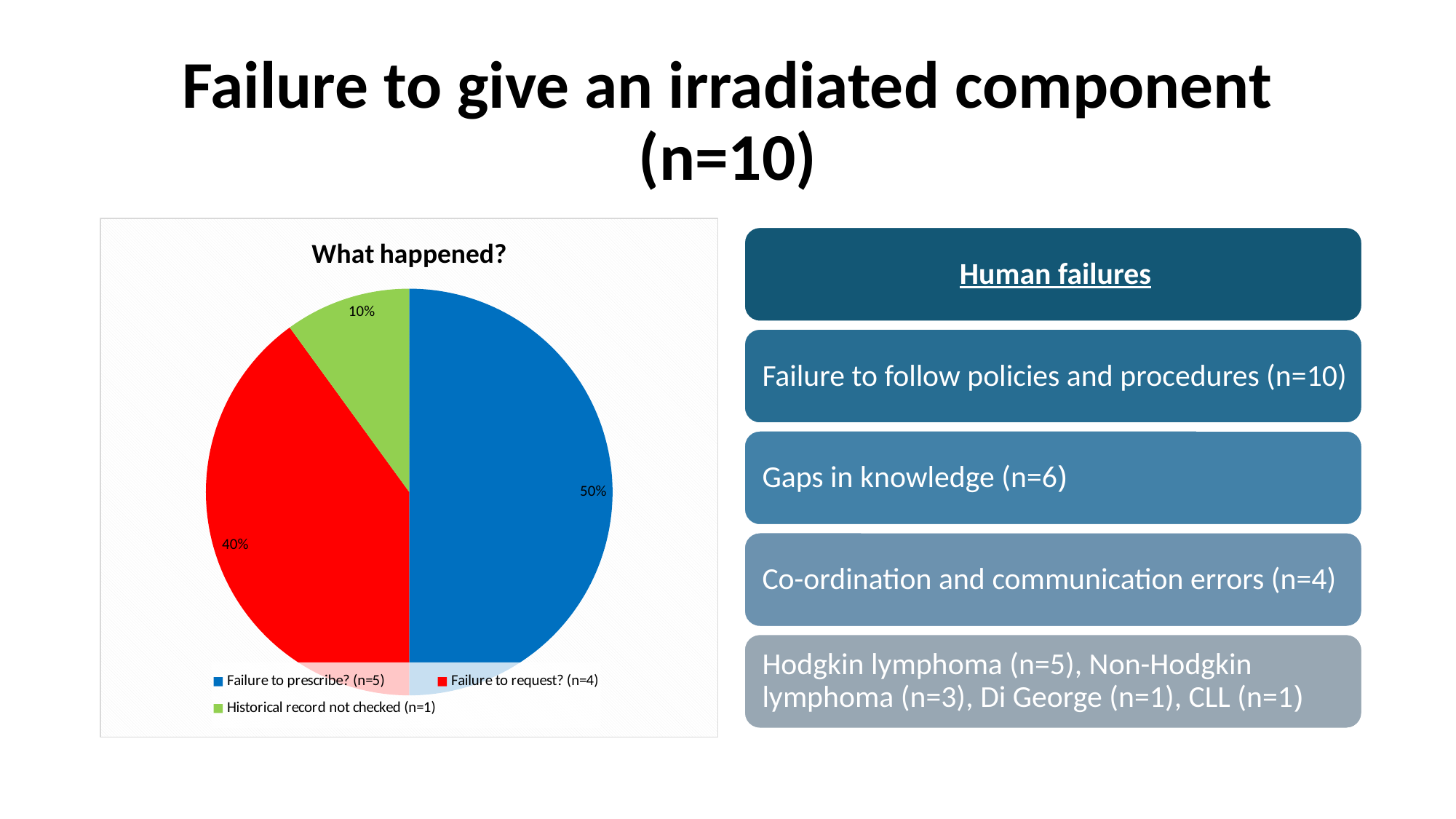
How many categories does the pie chart show? 3 Which category has the largest slice of the pie? Failure to prescribe? (n=5) What percentage of the pie is 'Historical record not checked (n=1)'? 10% What is the title of the chart? What happened? What kind of chart is shown on the slide? pie chart Which category has the smallest slice of the pie? Historical record not checked (n=1) What is the difference in percentage points between the 'Failure to prescribe? (n=5)' slice and the 'Failure to request? (n=4)' slice? 10% What is the difference in percentage points between the 'Failure to request? (n=4)' slice and the 'Historical record not checked (n=1)' slice? 30% What colour is the 'Failure to request? (n=4)' slice? red Which slice is larger: 'Failure to request? (n=4)' or 'Historical record not checked (n=1)'? Failure to request? (n=4) What percentage of the pie is 'Failure to request? (n=4)'? 40% What percentage of the pie is 'Failure to prescribe? (n=5)'? 50%